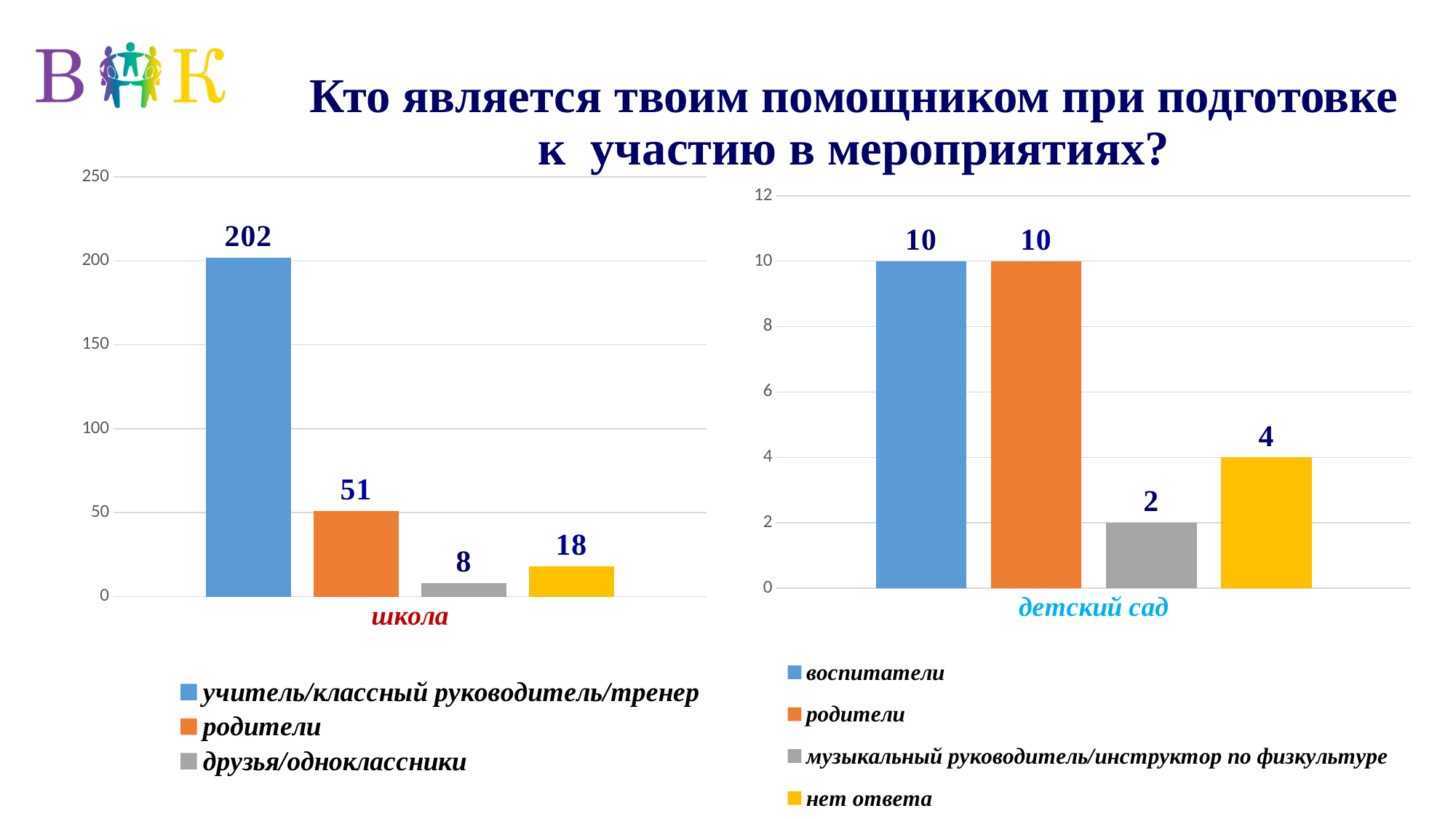
In the 'детский сад' chart, what is the value for музыкальный руководитель/инструктор по физкультуре? 2 In the 'детский сад' chart, what is the value for нет ответа? 4 In the 'школа' chart, what is the value for учитель/классный руководитель/тренер? 202 In the 'детский сад' chart, which is larger: the value for воспитатели or the value for нет ответа? воспитатели In the 'детский сад' chart, what is the difference between the values for родители and нет ответа? 6 In the 'школа' chart, what is the value for родители? 51 In the 'школа' chart, what is the value for друзья/одноклассники? 8 In the 'школа' chart, what is the difference between the values for учитель/классный руководитель/тренер and родители? 151 In the 'школа' chart, which category has the highest value? учитель/классный руководитель/тренер In the 'детский сад' chart, which category has the lowest value? музыкальный руководитель/инструктор по физкультуре What kind of chart is the 'школа' chart? bar chart How many series does the legend of the 'детский сад' chart list? 4